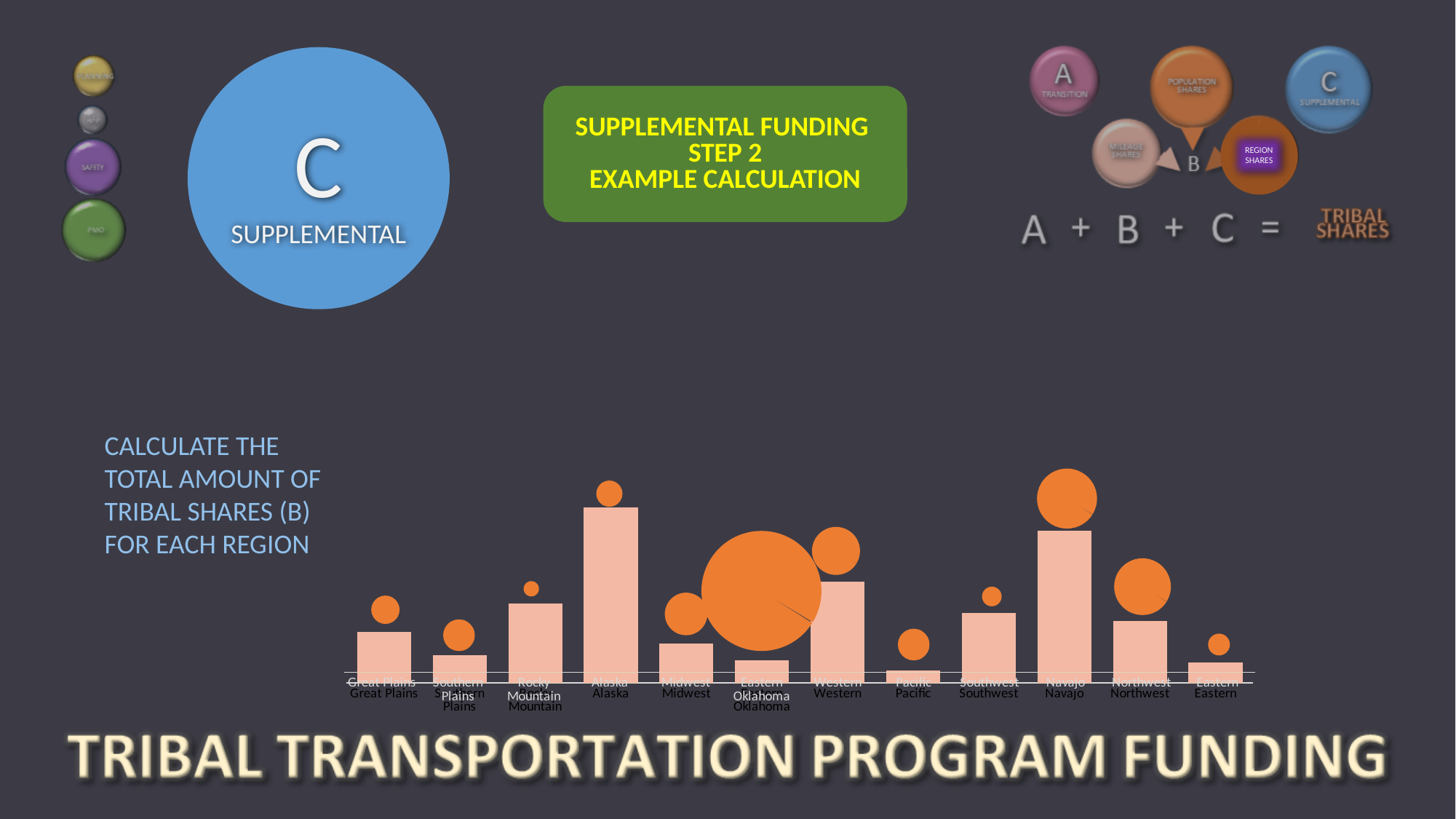
Which region has a taller bar, Rocky Mountain or Southern Plains? Rocky Mountain Which region has the shortest bar in the chart? Pacific What kind of chart is shown on the slide? bar chart Which region has a taller bar, Great Plains or Eastern Oklahoma? Great Plains What does the text to the left of the chart say the chart is used to calculate? The total amount of tribal shares (B) for each region Which region has a taller bar, Alaska or Midwest? Alaska Which region has the tallest bar in the chart? Alaska How many regions are shown along the x axis of the bar chart? 12 Which region has the largest orange circle above its bar? Eastern Oklahoma What is the first region listed on the left of the x axis? Great Plains